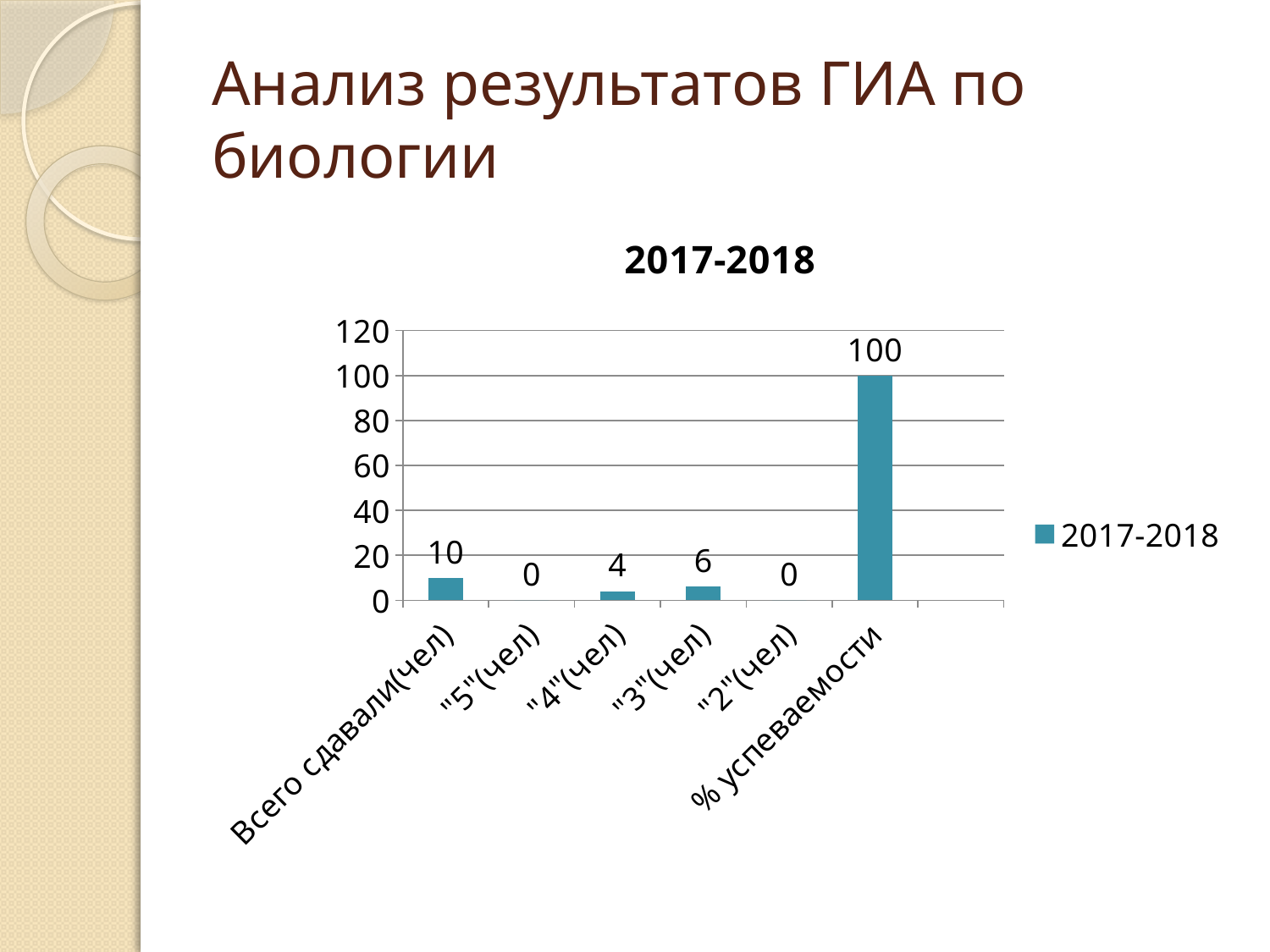
Which is larger, the value for "3"(чел) or the value for "4"(чел)? "3"(чел) What kind of chart is shown on the slide? bar chart Which category has the highest value? % успеваемости What is the value for "4"(чел)? 4 What is the value for "% успеваемости"? 100 What is the value for "3"(чел)? 6 What is the difference between the values for "3"(чел) and "4"(чел)? 2 What is the value for "5"(чел)? 0 What is the value for "Всего сдавали(чел)"? 10 What is the title of the chart? 2017-2018 How many categories are shown on the x axis? 6 How many series does the legend list? 1